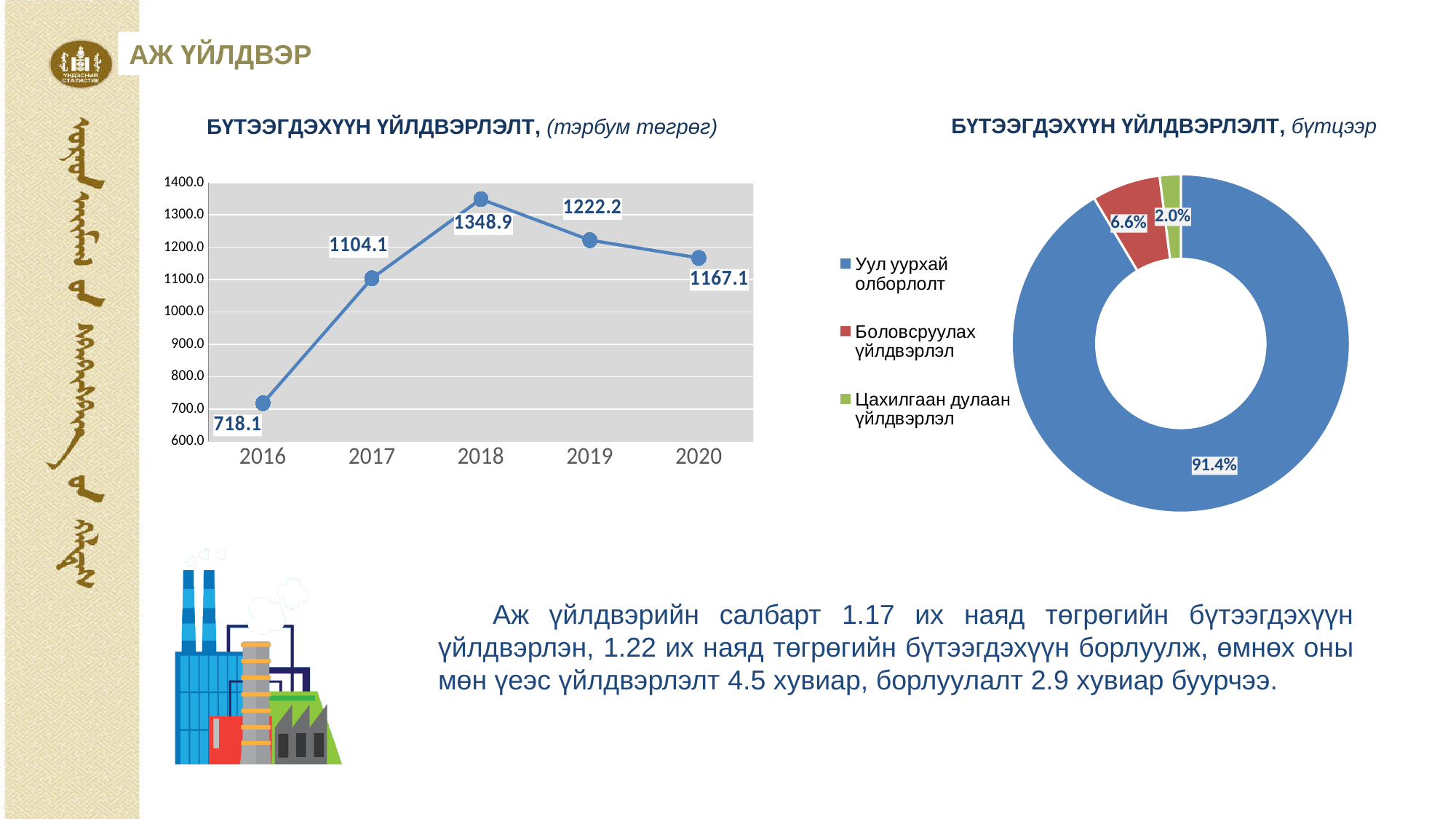
How many entries does the legend of the donut chart on the right list? 3 In the line chart on the left, which year has the highest value? 2018 In the line chart on the left, what is the difference between the 2019 and 2020 values? 55.1 In the donut chart on the right, what share does Цахилгаан дулаан үйлдвэрлэл have? 2.0% In the line chart on the left, which is larger, the value for 2017 or the value for 2020? 2020 In the line chart on the left, do the values rise or fall from 2018 to 2020? fall In the line chart on the left, which year has the lowest value? 2016 In the line chart on the left, what is the value for 2018? 1348.9 In the line chart on the left, what is the value for 2016? 718.1 In the donut chart on the right, what share does Уул уурхай олборлолт have? 91.4% In the line chart on the left, how many years are plotted? 5 What kind of chart is the chart on the left? line chart